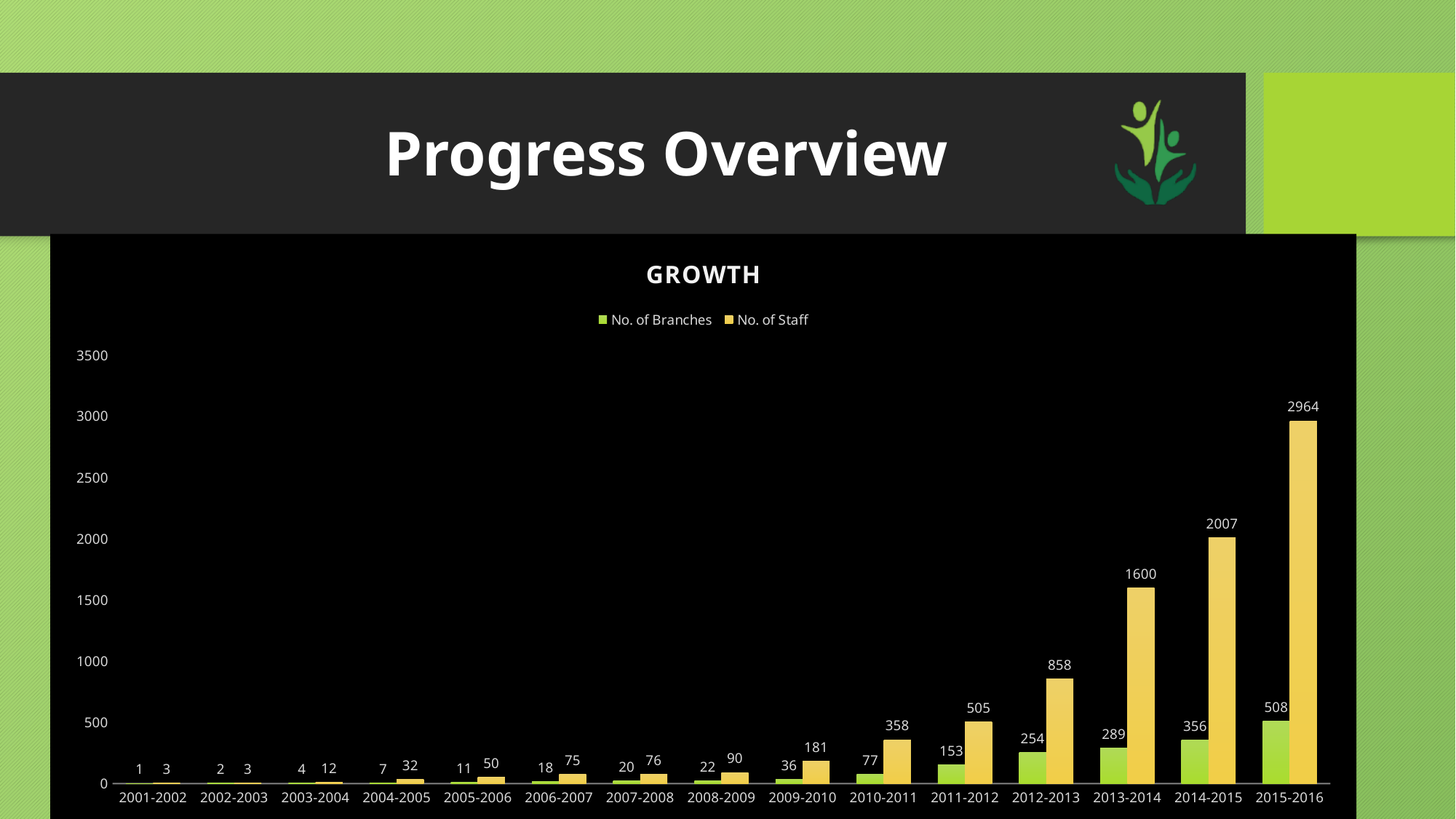
Which year has the lowest No. of Branches? 2001-2002 What is the difference between the No. of Staff in 2015-2016 and 2014-2015? 957 What is the No. of Staff for 2009-2010? 181 How many series does the legend list? 2 Which year has the highest No. of Staff? 2015-2016 What is the No. of Staff for 2015-2016? 2964 How many year categories are shown on the x axis? 15 What is the No. of Branches for 2012-2013? 254 Does the No. of Staff rise or fall from 2001-2002 to 2015-2016? rise What kind of chart is shown? bar chart Which is larger: the No. of Staff in 2011-2012 or the No. of Branches in 2015-2016? No. of Branches in 2015-2016 Is the No. of Staff for 2013-2014 greater or less than 1500? greater